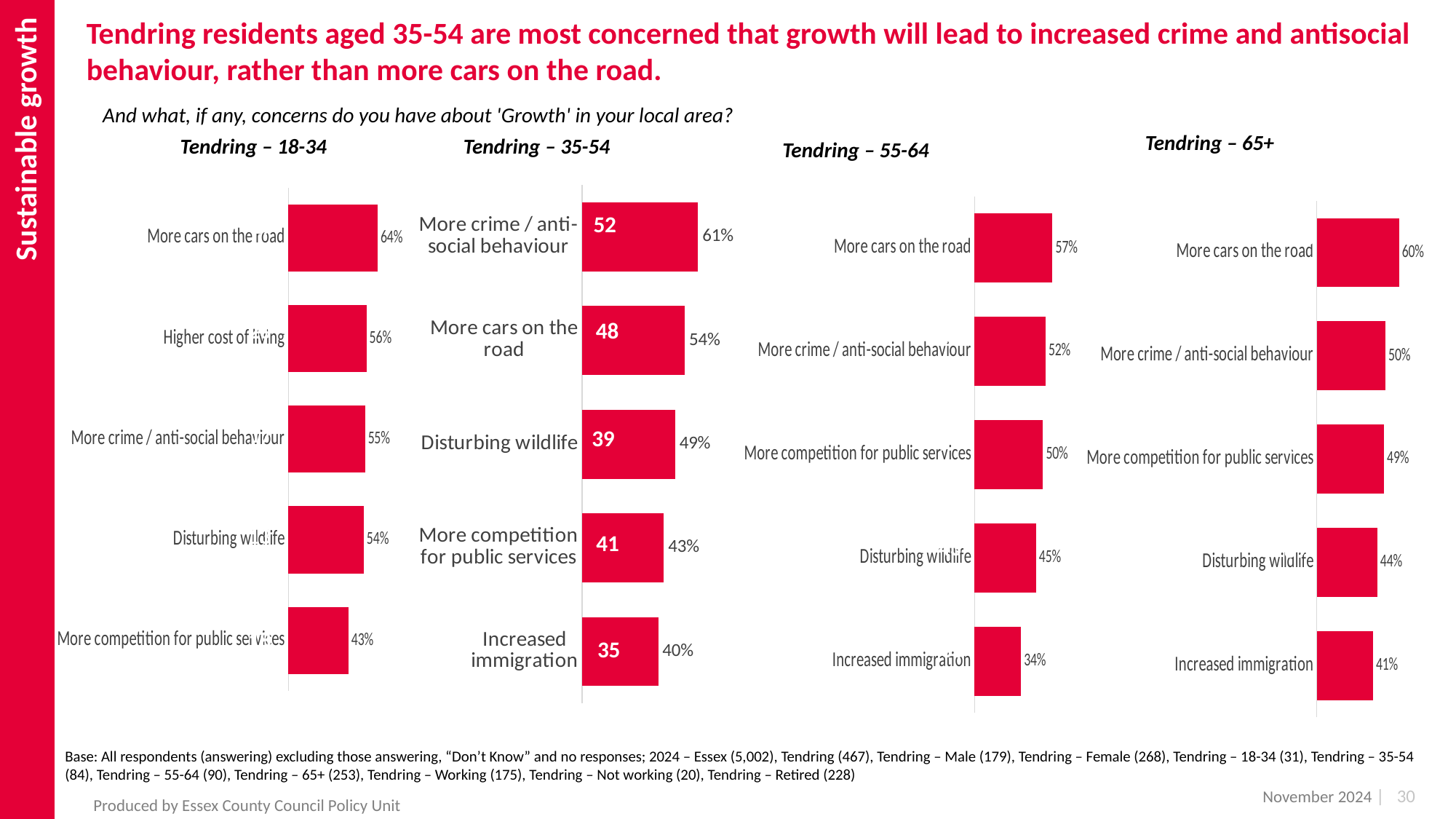
In the 'Tendring – 65+' chart, what is the value for 'More competition for public services'? 49% How many charts are shown on the slide? 4 In the 'Tendring – 35-54' chart, which concern has the highest percentage? More crime / anti-social behaviour In the 'Tendring – 55-64' chart, what is the difference in percentage points between 'More cars on the road' and 'Increased immigration'? 23 In the 'Tendring – 35-54' chart, what is the difference in percentage points between 'More crime / anti-social behaviour' and 'More cars on the road'? 7 In the 'Tendring – 18-34' chart, what is the value for 'More cars on the road'? 64% In the 'Tendring – 35-54' chart, what percentage is shown for 'Disturbing wildlife'? 49% How many concerns are plotted in the 'Tendring – 55-64' chart? 5 In the 'Tendring – 65+' chart, which concern has the lowest percentage? Increased immigration Which is larger: 'More cars on the road' in the 'Tendring – 18-34' chart or 'More cars on the road' in the 'Tendring – 65+' chart? Tendring – 18-34 What type of chart is used for 'Tendring – 18-34'? Bar chart In the 'Tendring – 55-64' chart, what is the value for 'Increased immigration'? 34%